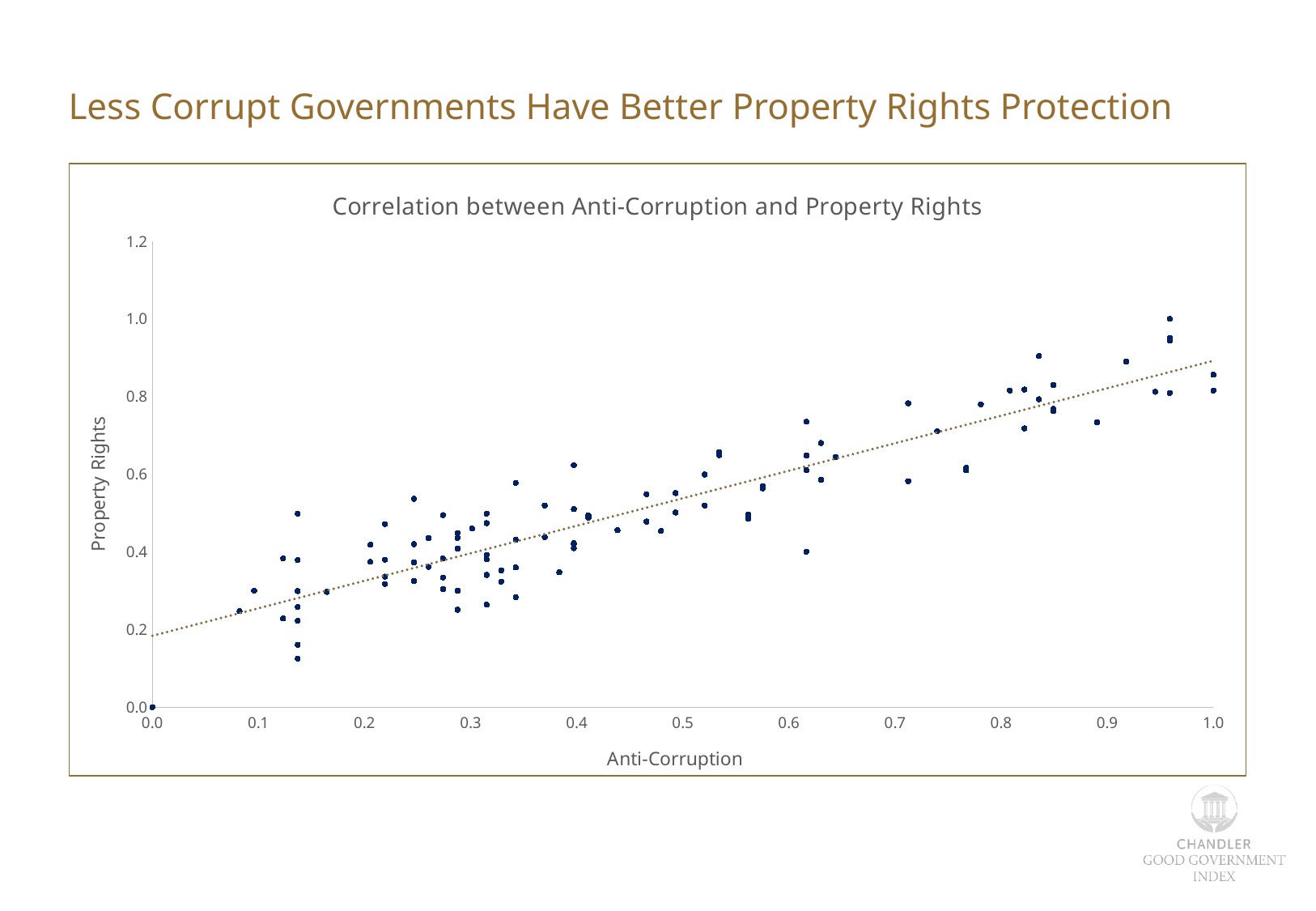
What is the Property Rights value of the point plotted at Anti-Corruption 0.0? 0.0 Is the Property Rights value of the lowest point near Anti-Corruption 0.14 greater or less than 0.2? less Is the Property Rights value of the highest point (near Anti-Corruption 0.96) greater or less than 0.8? greater What is the label of the horizontal axis? Anti-Corruption Does the dotted trend line slope upward or downward from left to right? Upward Are the Property Rights values of the points at Anti-Corruption 1.0 greater or less than 0.6? greater What is the maximum value shown on the Property Rights axis? 1.2 What kind of chart is shown on the slide? Scatter chart Do Property Rights values generally rise or fall as Anti-Corruption increases along the x axis? Rise Which has higher Property Rights values overall: the points near Anti-Corruption 0.1 or the points near Anti-Corruption 0.9? The points near 0.9 What is the title of the chart? Correlation between Anti-Corruption and Property Rights